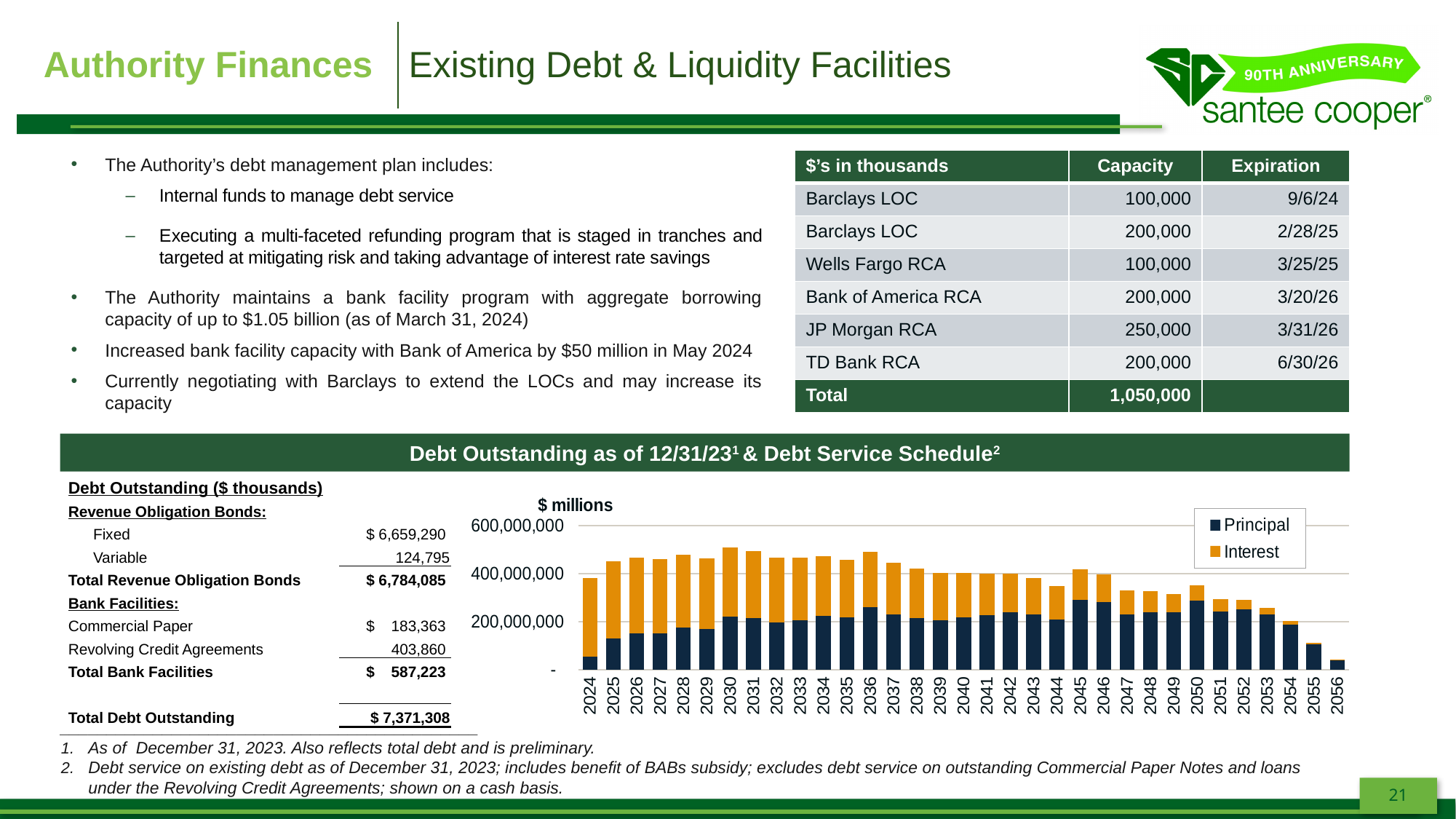
How many years are shown on the x axis of the debt service chart? 33 Is the total bar for 2055 in the debt service chart greater or less than 200,000,000? less Is the total bar for 2030 in the debt service chart greater or less than 400,000,000? greater What kind of chart is shown under the heading 'Debt Outstanding as of 12/31/23 & Debt Service Schedule'? Stacked bar chart What is the first year shown on the x axis of the debt service chart? 2024 Do the total bars in the debt service chart rise or fall from 2050 to 2056? fall Which year has the lowest total bar in the debt service chart? 2056 How many series does the legend of the debt service chart list? 2 What are the two series named in the legend of the debt service chart? Principal and Interest Is the Principal value for 2045 in the debt service chart greater or less than 200,000,000? greater In the debt service chart, which is larger: the Principal value for 2050 or the Principal value for 2024? 2050